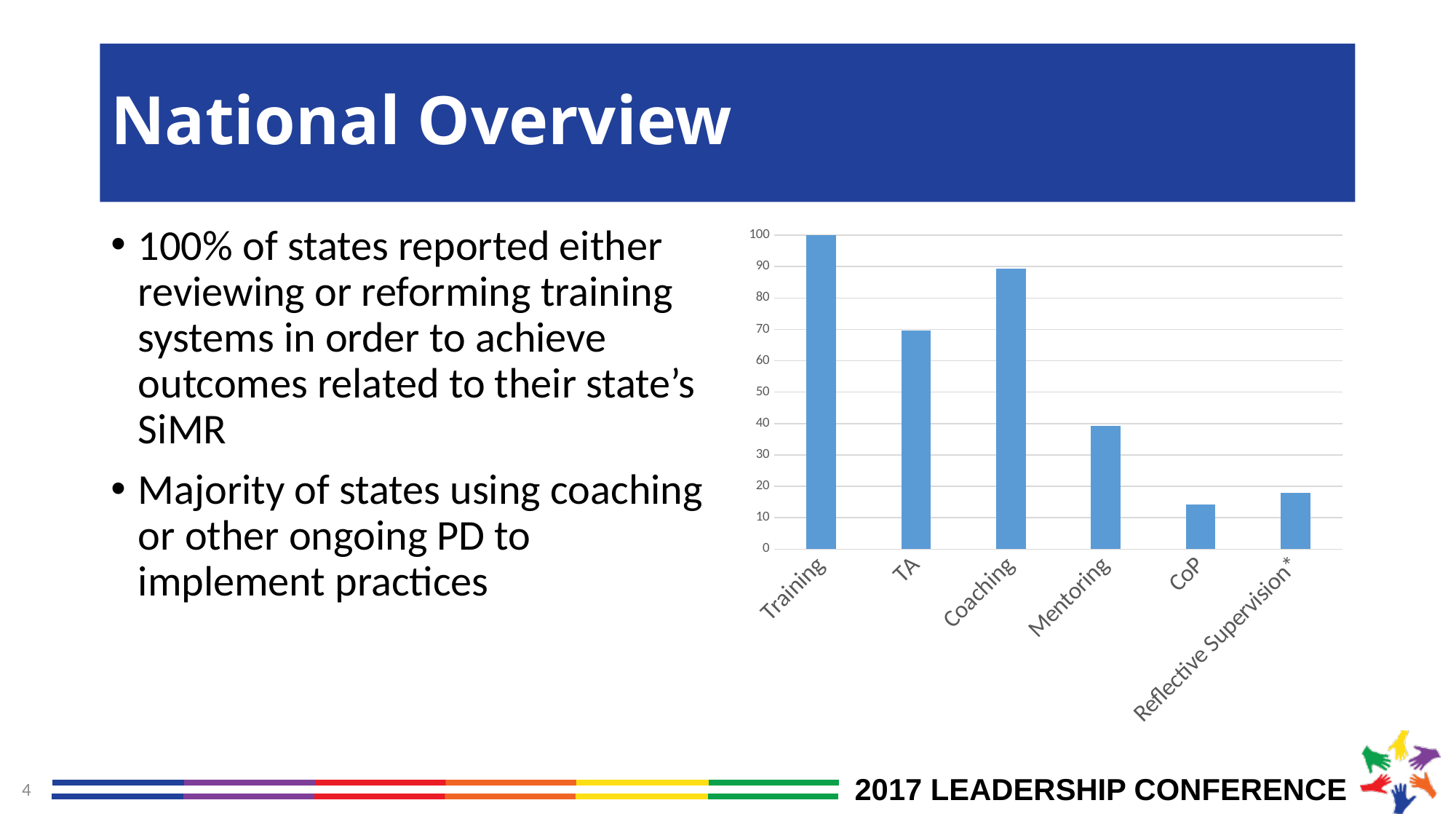
Is the value for Coaching greater or less than 80? greater Is the value for Mentoring greater or less than 30? greater Is the value for Reflective Supervision* greater or less than 20? less Which category has the highest bar in the chart? Training Which is larger, the value for Coaching or the value for TA? Coaching What kind of chart is shown on the slide? bar chart How many categories are shown on the x axis of the chart? 6 Which is larger, the value for CoP or the value for Reflective Supervision*? Reflective Supervision* What is the value for Training in the chart? 100 Which category has the lowest bar in the chart? CoP